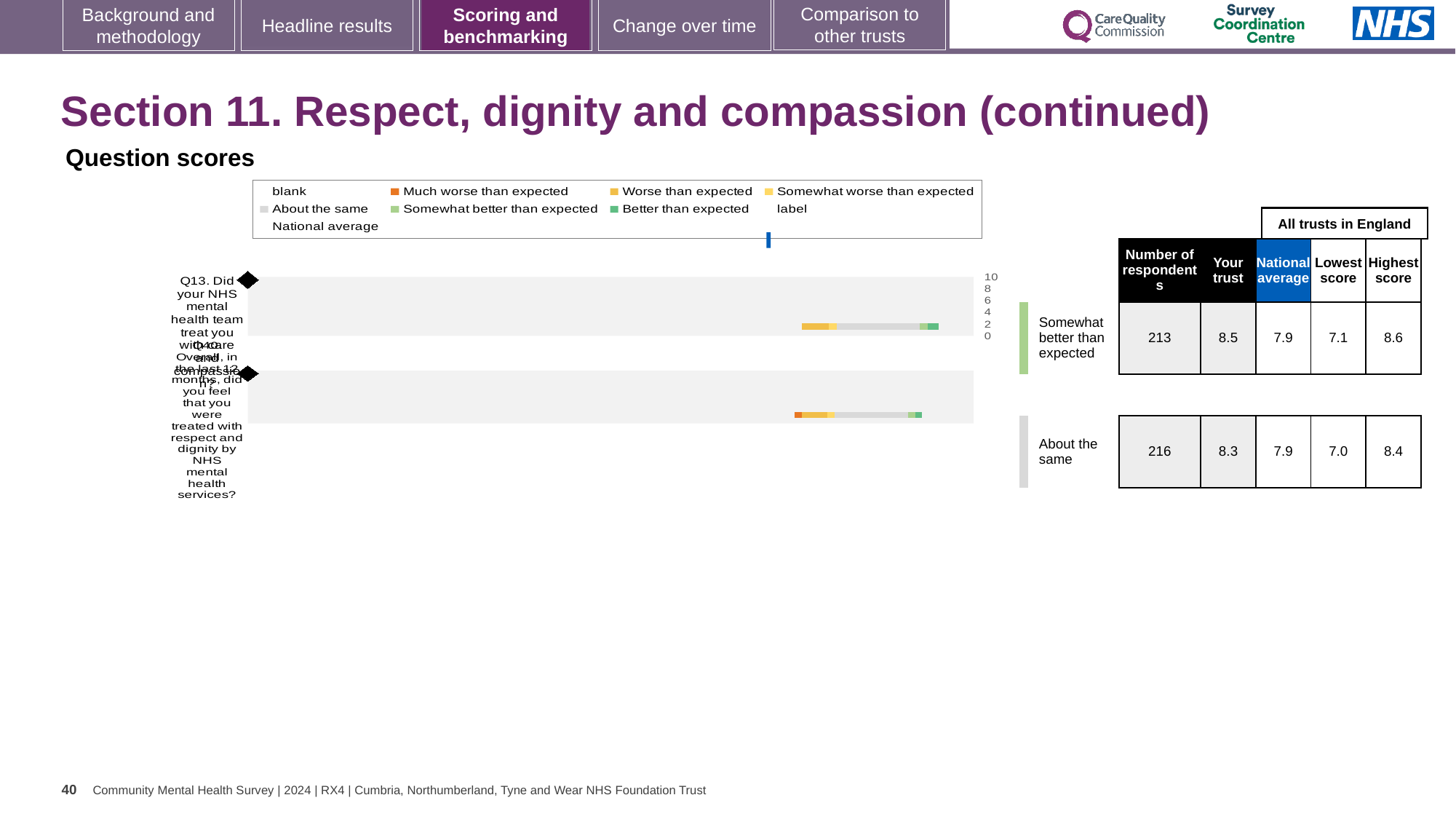
How many questions (categories) are plotted in the question scores chart? 2 What kind of chart is used to show the question scores on this slide? bar chart Which question has the higher 'Your trust' score, Q13 or Q14? Q13 How many respondents are listed for Q14? 216 What benchmark category label is shown for Q13? Somewhat better than expected In the table next to the chart, what is the 'Your trust' score for Q14? 8.3 What is the highest score across all trusts in England for Q13? 8.6 What is the national average score shown for Q13? 7.9 What benchmark category label is shown for Q14? About the same What is the lowest score across all trusts in England for Q14? 7.0 What is the difference between the 'Your trust' score and the national average for Q13? 0.6 In the table next to the chart, what is the 'Your trust' score for Q13? 8.5